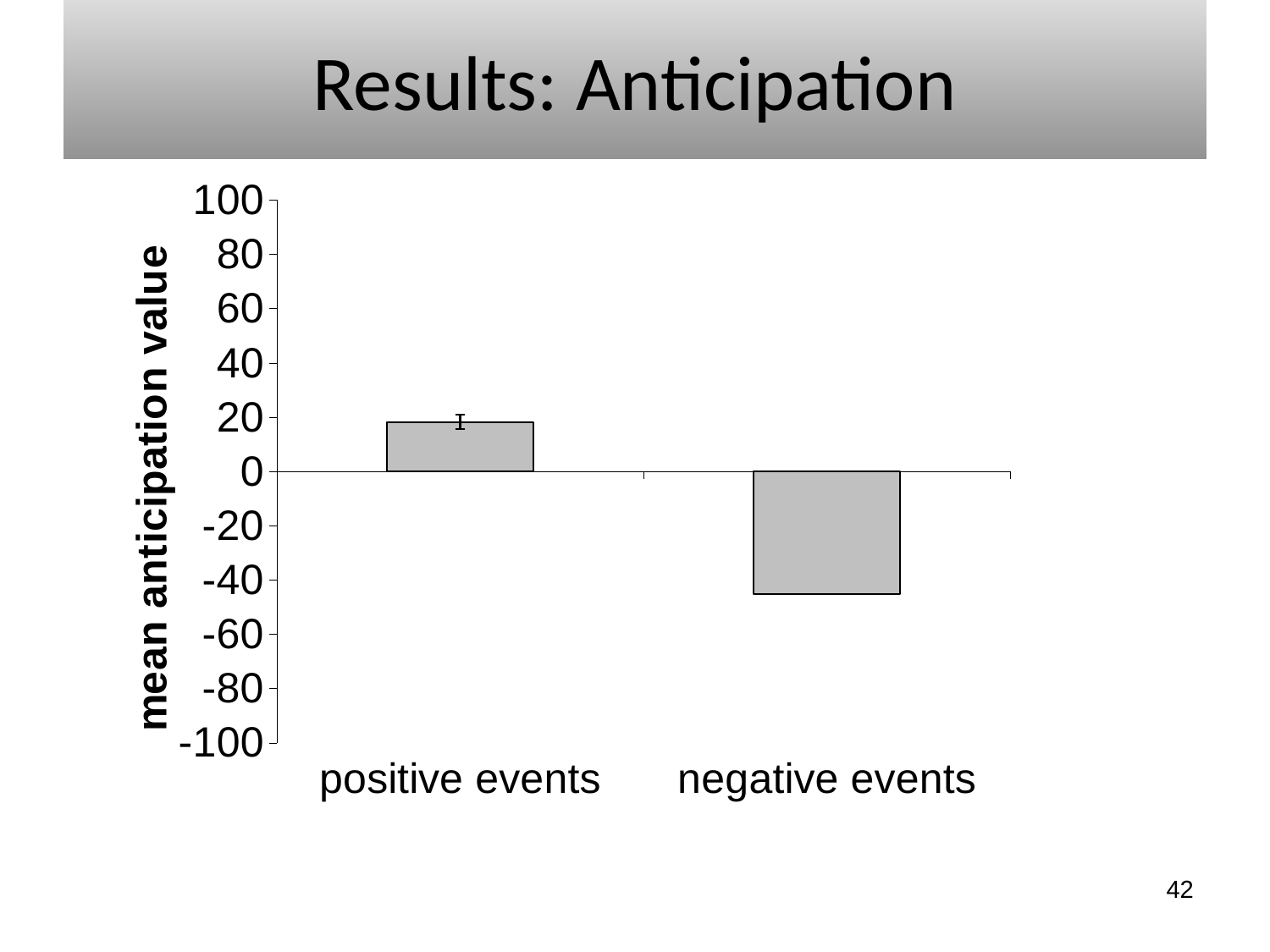
Which category has the lowest mean anticipation value? negative events Which has a larger mean anticipation value, positive events or negative events? positive events Do the values rise or fall from positive events to negative events along the x axis? fall Is the value for positive events greater or less than 0? greater How many categories are shown on the x axis of the chart? 2 Is the value for negative events greater or less than -60? greater Is the value for positive events greater or less than 40? less What is the title of the slide containing the chart? Results: Anticipation Which category has the highest mean anticipation value? positive events What kind of chart is shown on the slide? bar chart What is the label of the y axis of the chart? mean anticipation value